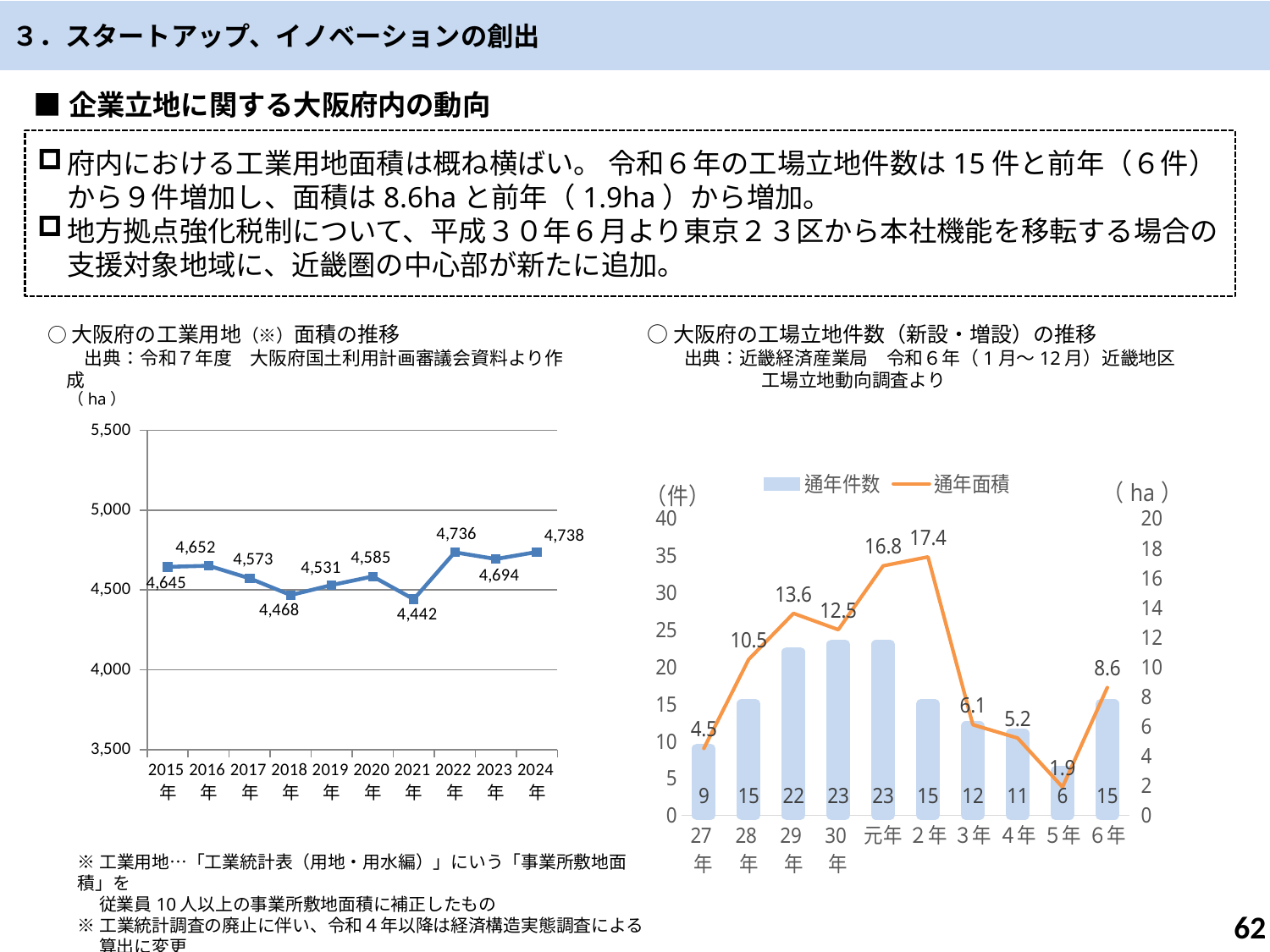
In the right chart (大阪府の工場立地件数の推移), what is the 通年件数 value for 6年? 15 In the right chart (大阪府の工場立地件数の推移), what is the 通年面積 value for 2年? 17.4 How many series does the legend of the right chart (大阪府の工場立地件数の推移) list? 2 In the left chart (大阪府の工業用地面積の推移), what is the difference between the values for 2022年 and 2021年? 294 In the right chart (大阪府の工場立地件数の推移), which year has the highest 通年面積? 2年 In the right chart (大阪府の工場立地件数の推移), is the 通年件数 for 29年 larger or smaller than that for 3年? larger In the left chart (大阪府の工業用地面積の推移), what is the value for 2024年? 4,738 In the left chart (大阪府の工業用地面積の推移), how many years are plotted on the x axis? 10 In the right chart (大阪府の工場立地件数の推移), which year has the lowest 通年件数? 5年 In the right chart (大阪府の工場立地件数の推移), what is the difference in 通年件数 between 6年 and 5年? 9 What kind of chart is the left chart (大阪府の工業用地面積の推移)? line chart In the left chart (大阪府の工業用地面積の推移), which year has the lowest value? 2021年